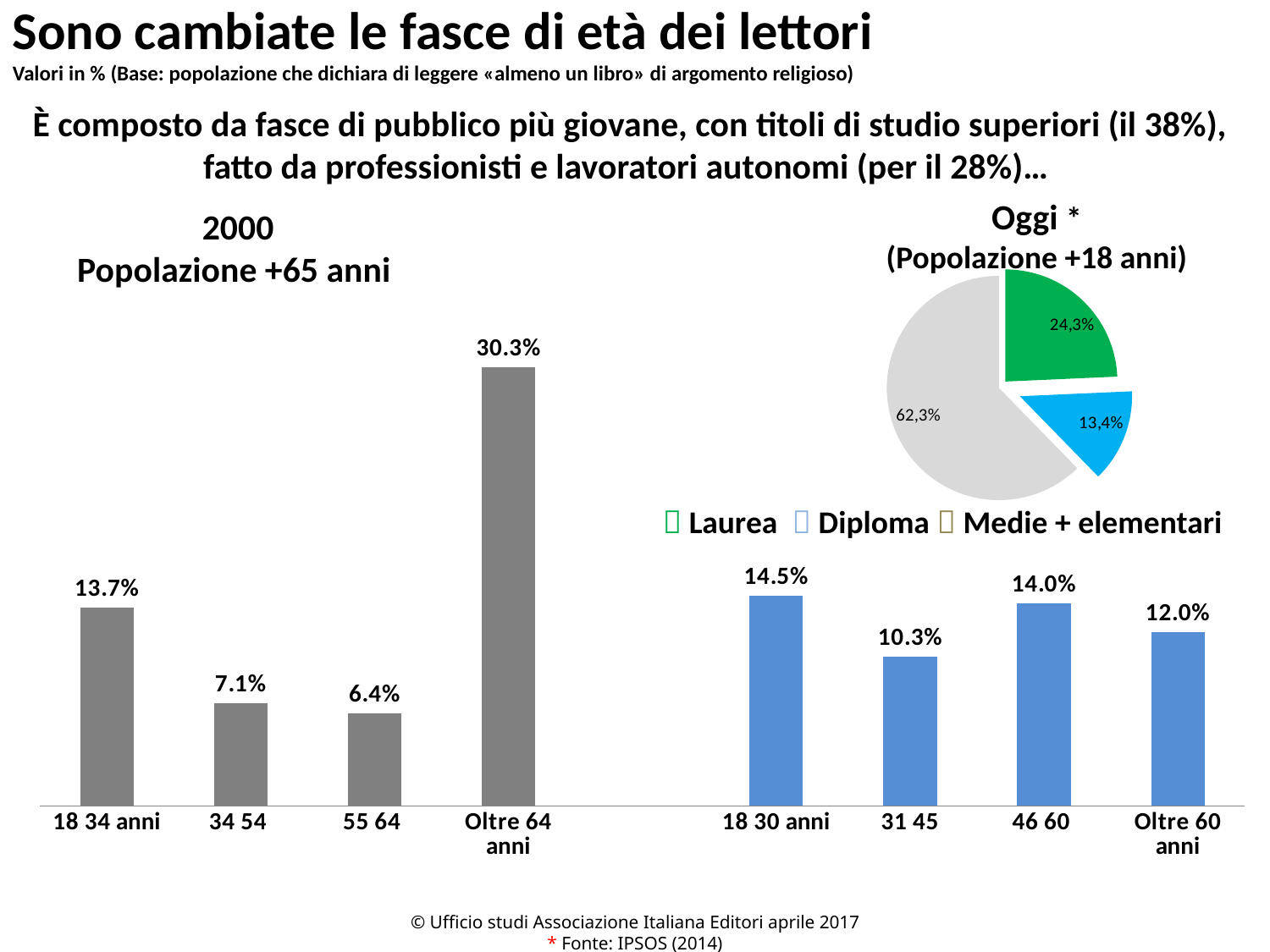
In the right bar chart (Oggi, Popolazione +18 anni), which category has the highest value? 18 30 anni In the right bar chart (Oggi, Popolazione +18 anni), what is the value for '31 45'? 10.3% In the left bar chart (2000, Popolazione +65 anni), how many categories are shown? 4 In the left bar chart (2000, Popolazione +65 anni), which category has the lowest value? 55 64 In the left bar chart (2000, Popolazione +65 anni), what is the value for 'Oltre 64 anni'? 30.3% In the left bar chart (2000, Popolazione +65 anni), what is the difference between the values for '18 34 anni' and '34 54'? 6.6% In the right bar chart (Oggi, Popolazione +18 anni), which is larger, the value for '46 60' or the value for 'Oltre 60 anni'? 46 60 In the pie chart (Oggi, Popolazione +18 anni), what share does 'Laurea' have? 24,3% In the right bar chart (Oggi, Popolazione +18 anni), what is the difference between the values for '18 30 anni' and 'Oltre 60 anni'? 2.5% How many entries does the legend of the pie chart list? 3 What kind of chart is the chart on the left of the slide (2000, Popolazione +65 anni)? Bar chart In the pie chart (Oggi, Popolazione +18 anni), which slice is the largest? Medie + elementari